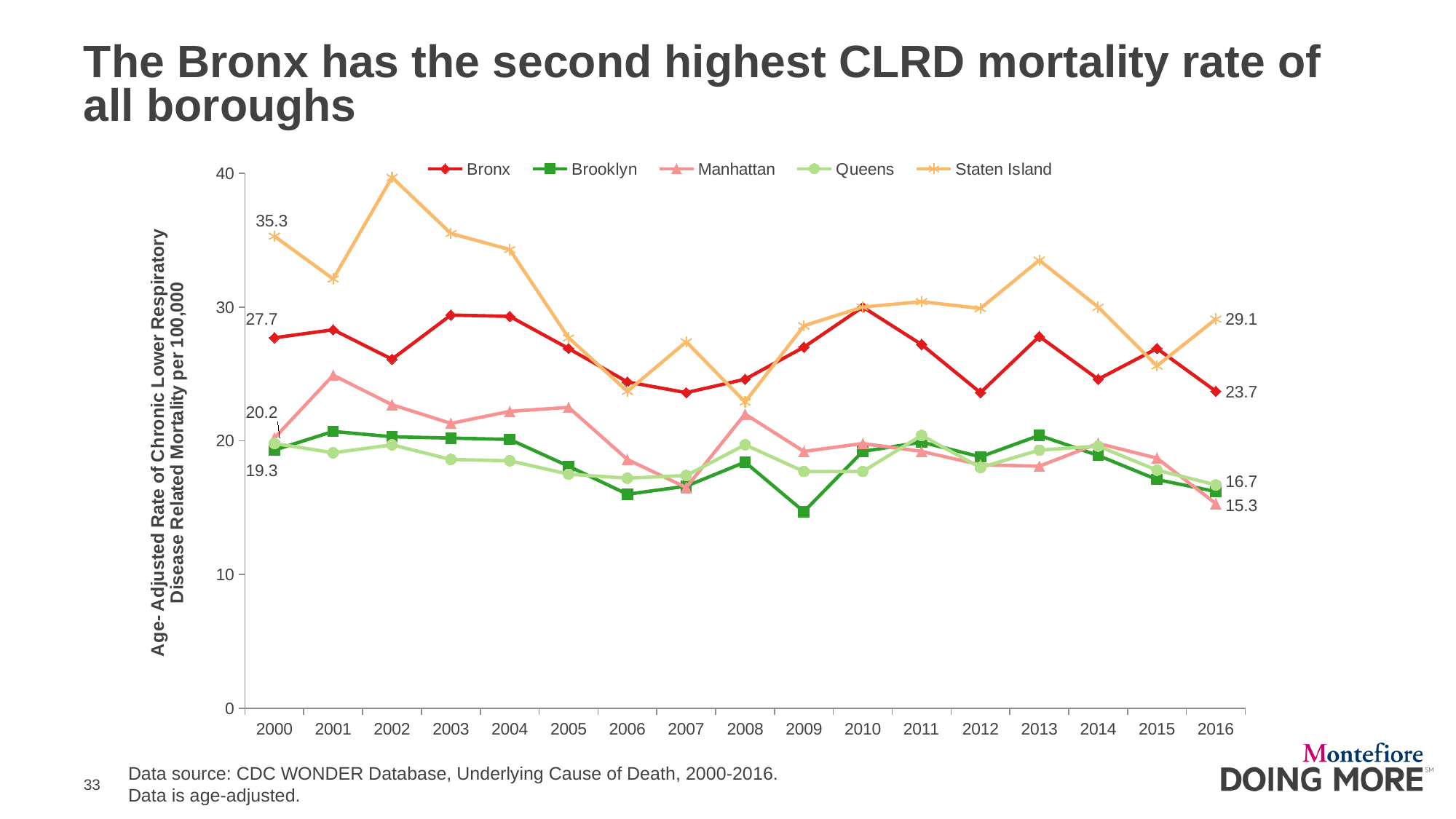
Is the Staten Island CLRD mortality rate in 2002 greater or less than 30? greater What is the Staten Island CLRD mortality rate in 2000? 35.3 What kind of chart is shown on the slide? line chart What is the difference between the Staten Island and Bronx CLRD mortality rates in 2016? 5.4 Which borough has the lowest CLRD mortality rate in 2016? Manhattan By how much did the Bronx CLRD mortality rate fall from 2000 to 2016? 4.0 Which borough has the highest CLRD mortality rate in 2016? Staten Island What is the Bronx CLRD mortality rate in 2016? 23.7 How many boroughs are listed in the legend? 5 What is the Staten Island CLRD mortality rate in 2016? 29.1 What is the Manhattan CLRD mortality rate in 2016? 15.3 What is the Bronx CLRD mortality rate in 2000? 27.7